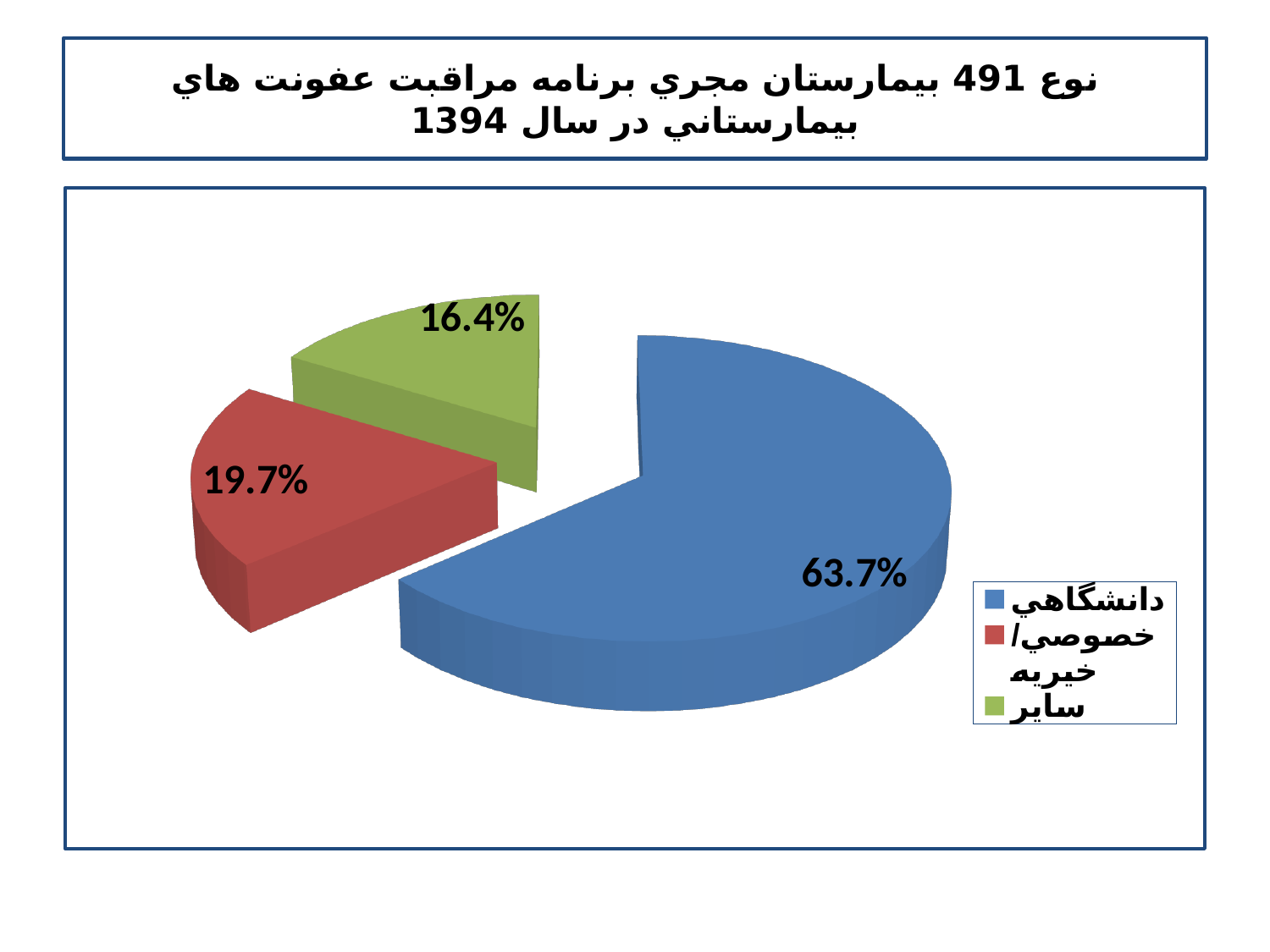
Which category has the smallest slice of the pie? ساير Which category has the largest slice of the pie? دانشگاهي What type of chart is shown on the slide? pie chart What share of the pie does the ساير slice represent? 16.4% What share of the pie does the خصوصي/خيريه slice represent? 19.7% How many entries does the legend list? 3 Which is larger, the خصوصي/خيريه slice or the ساير slice? خصوصي/خيريه What is the difference in percentage points between the خصوصي/خيريه slice and the ساير slice? 3.3 What colour is the دانشگاهي slice in the pie chart? blue What share of the pie does the دانشگاهي slice represent? 63.7% What is the difference in percentage points between the دانشگاهي slice and the خصوصي/خيريه slice? 44 How many slices does the pie chart have? 3